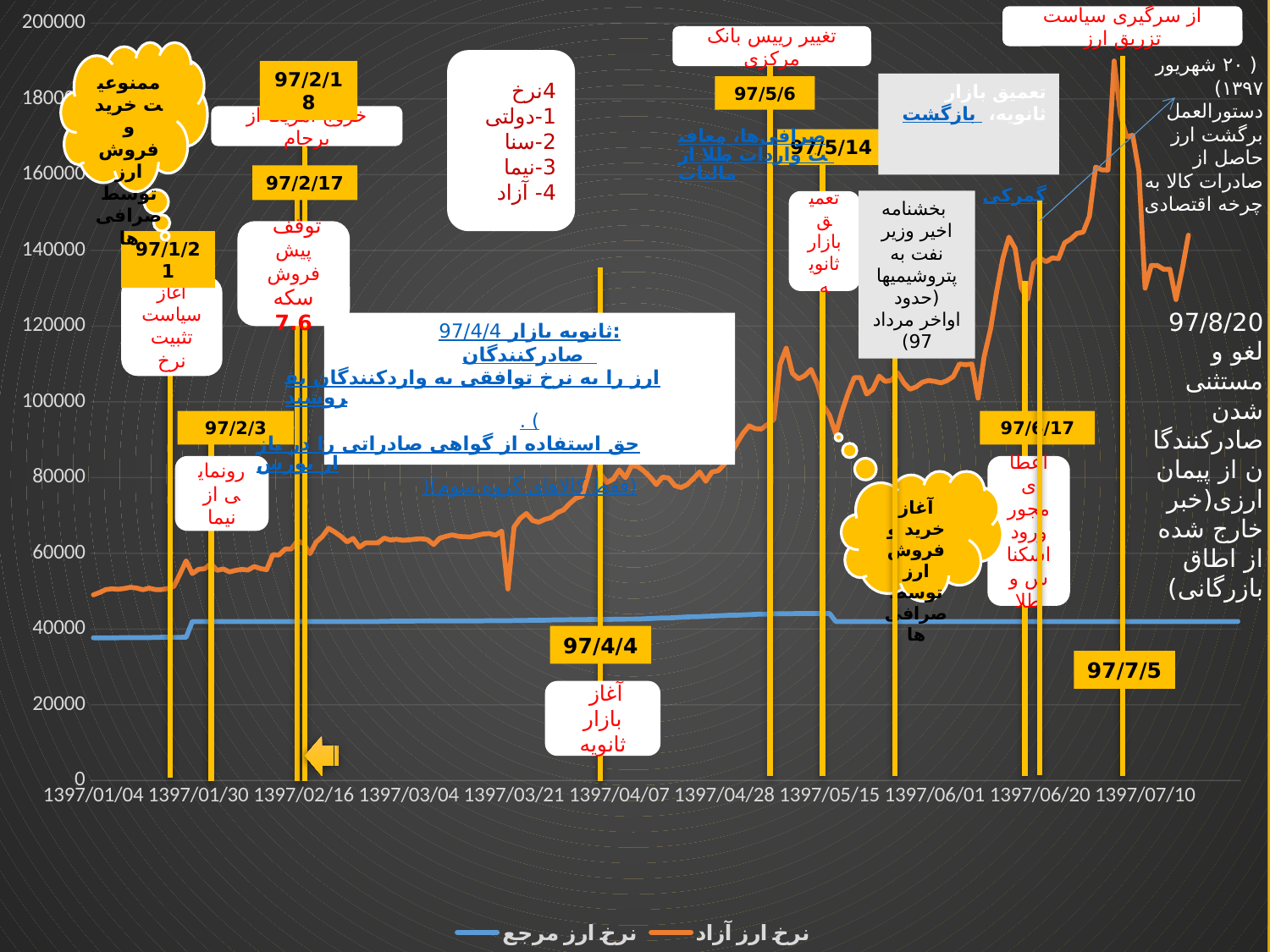
Is the peak value of نرخ ارز آزاد greater or less than 160000? greater Is the value of نرخ ارز آزاد at 1397/05/15 greater or less than 80000? greater Does نرخ ارز آزاد generally rise or fall from 1397/01/04 to 1397/07/10? rise At 1397/04/07, which series has the higher value, نرخ ارز آزاد or نرخ ارز مرجع? نرخ ارز آزاد What is the first date label on the x axis? 1397/01/04 Is the value of نرخ ارز آزاد at 1397/03/04 greater or less than 80000? less How many series does the legend list? 2 What are the two series named in the legend? نرخ ارز آزاد and نرخ ارز مرجع What kind of chart is shown on the slide? line chart Which series reaches the highest value on the chart? نرخ ارز آزاد